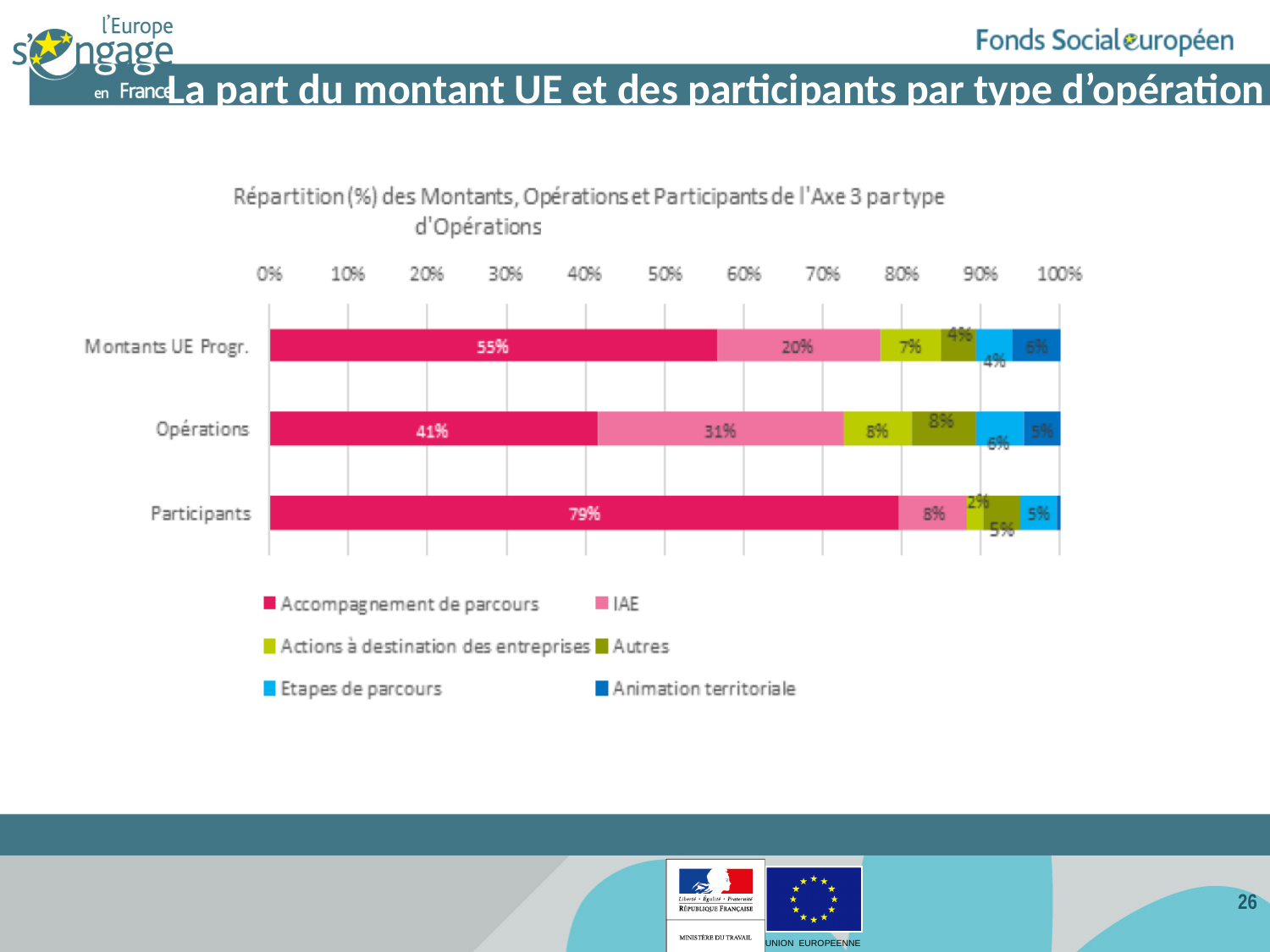
Which category has the highest value for Accompagnement de parcours? Participants What is the title of the chart? Répartition (%) des Montants, Opérations et Participants de l'Axe 3 par type d'Opérations How many series does the legend list? 6 How many categories are plotted on the vertical axis? 3 What is the value of Animation territoriale for Montants UE Progr.? 6% What is the value of Accompagnement de parcours for Participants? 79% What is the difference between the Accompagnement de parcours values for Participants and Montants UE Progr.? 24% What is the value of IAE for Opérations? 31% Is the IAE value larger for Opérations or for Participants? Opérations Which category has the lowest value for Accompagnement de parcours? Opérations What is the value of Accompagnement de parcours for Montants UE Progr.? 55% What kind of chart is shown on the slide? Stacked bar chart